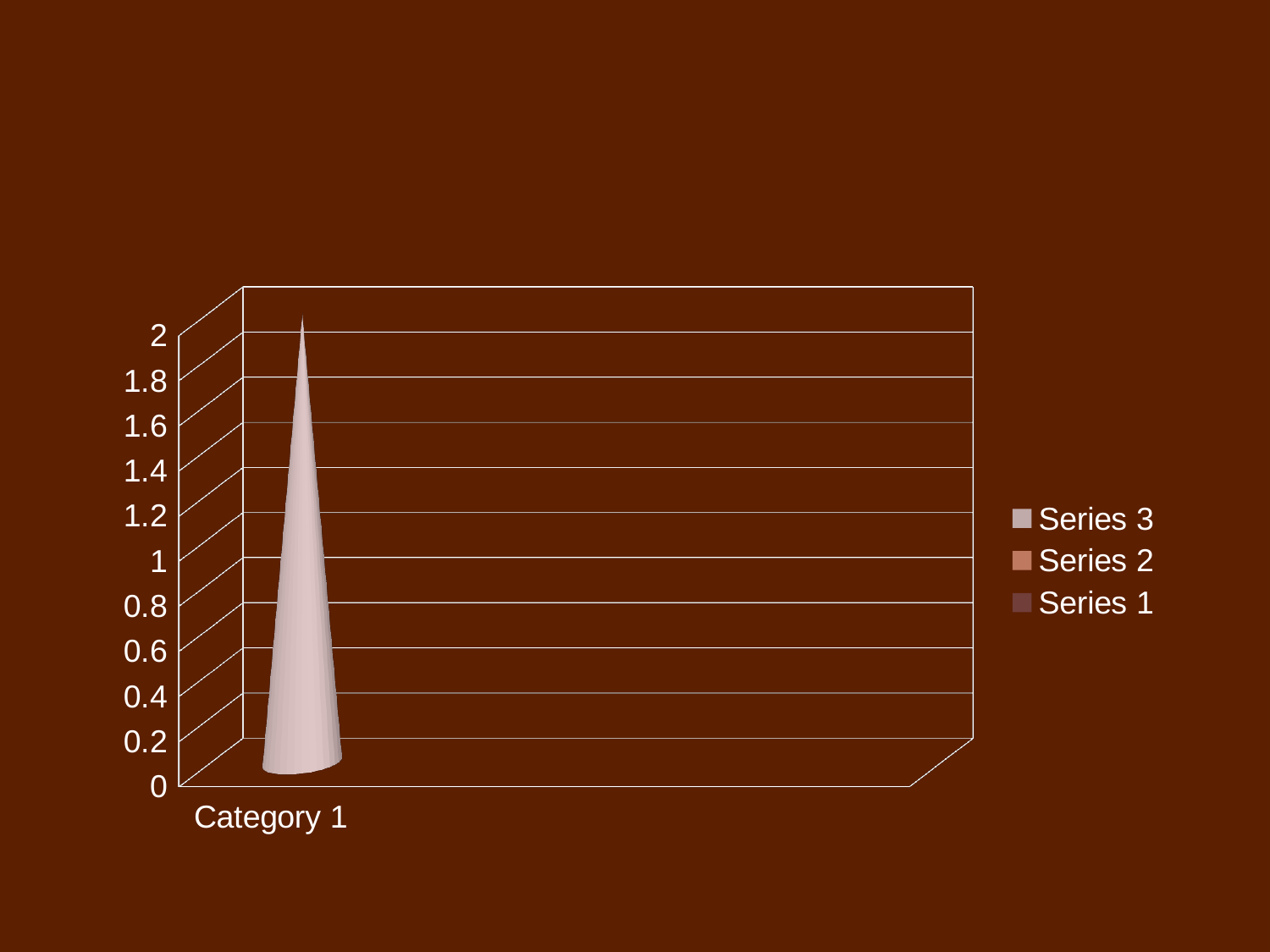
What kind of chart is shown on the slide? bar chart How many series does the chart's legend list? 3 Is the value of the visible bar for Category 1 greater or less than 0.4? greater What is the label of the only category on the x axis? Category 1 What is the highest value shown on the vertical axis of the chart? 2 How many categories are shown on the x axis of the chart? 1 Is the value of the visible bar for Category 1 greater or less than 1? greater